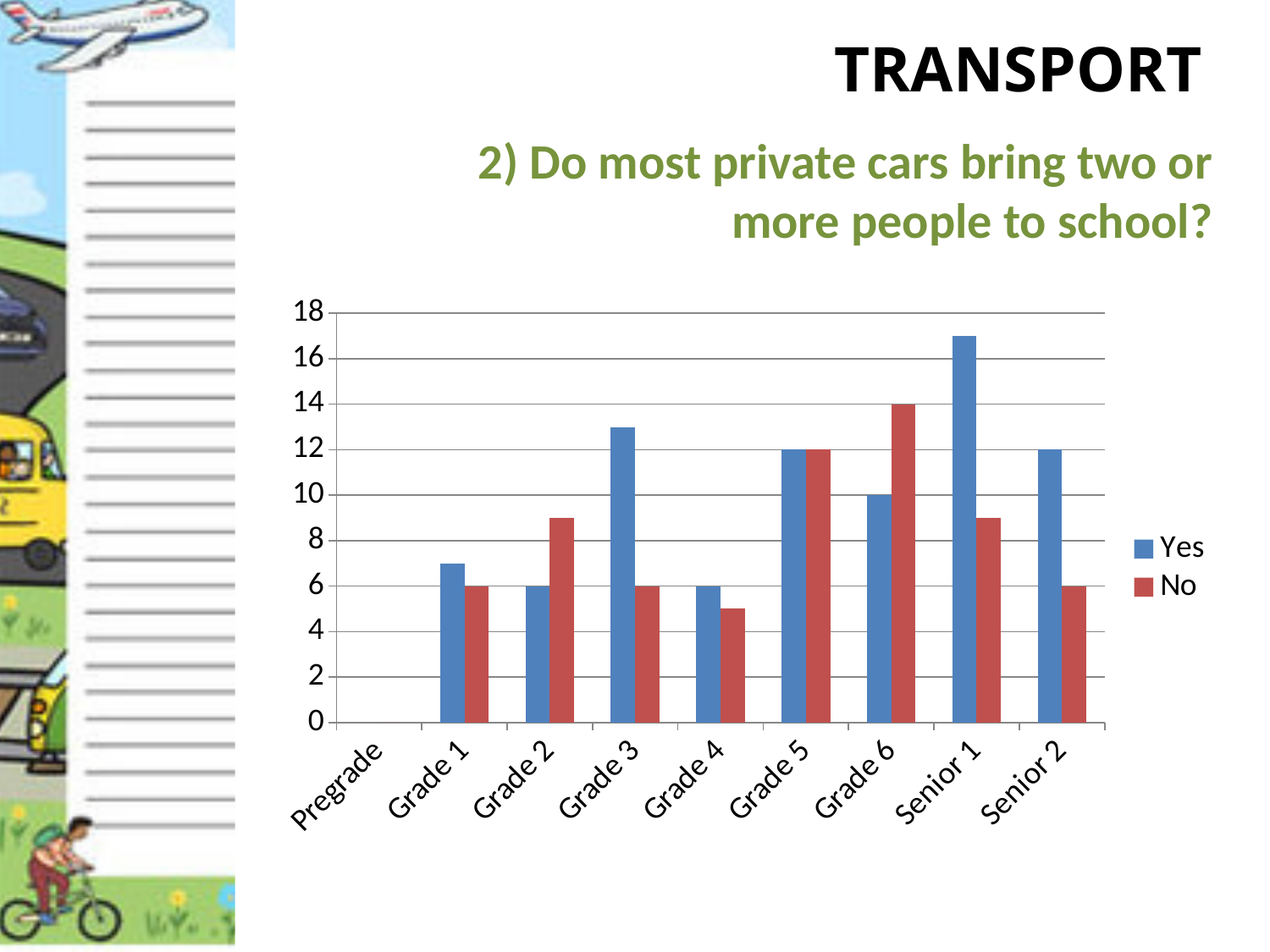
Which grade has the highest No value? Grade 6 Is the Yes value for Senior 1 greater or less than 16? greater How many grade categories are shown on the x axis? 9 What is the value of the No bar for Grade 6? 14 For Grade 6, which is larger, the Yes bar or the No bar? No What kind of chart is shown on the slide? bar chart What is the value of the Yes bar for Grade 6? 10 What is the difference between the No and Yes values for Grade 6? 4 Is the Yes value for Grade 3 greater or less than 12? greater What is the value of the Yes bar for Grade 5? 12 Which grade has the highest Yes value? Senior 1 How many series does the legend list? 2